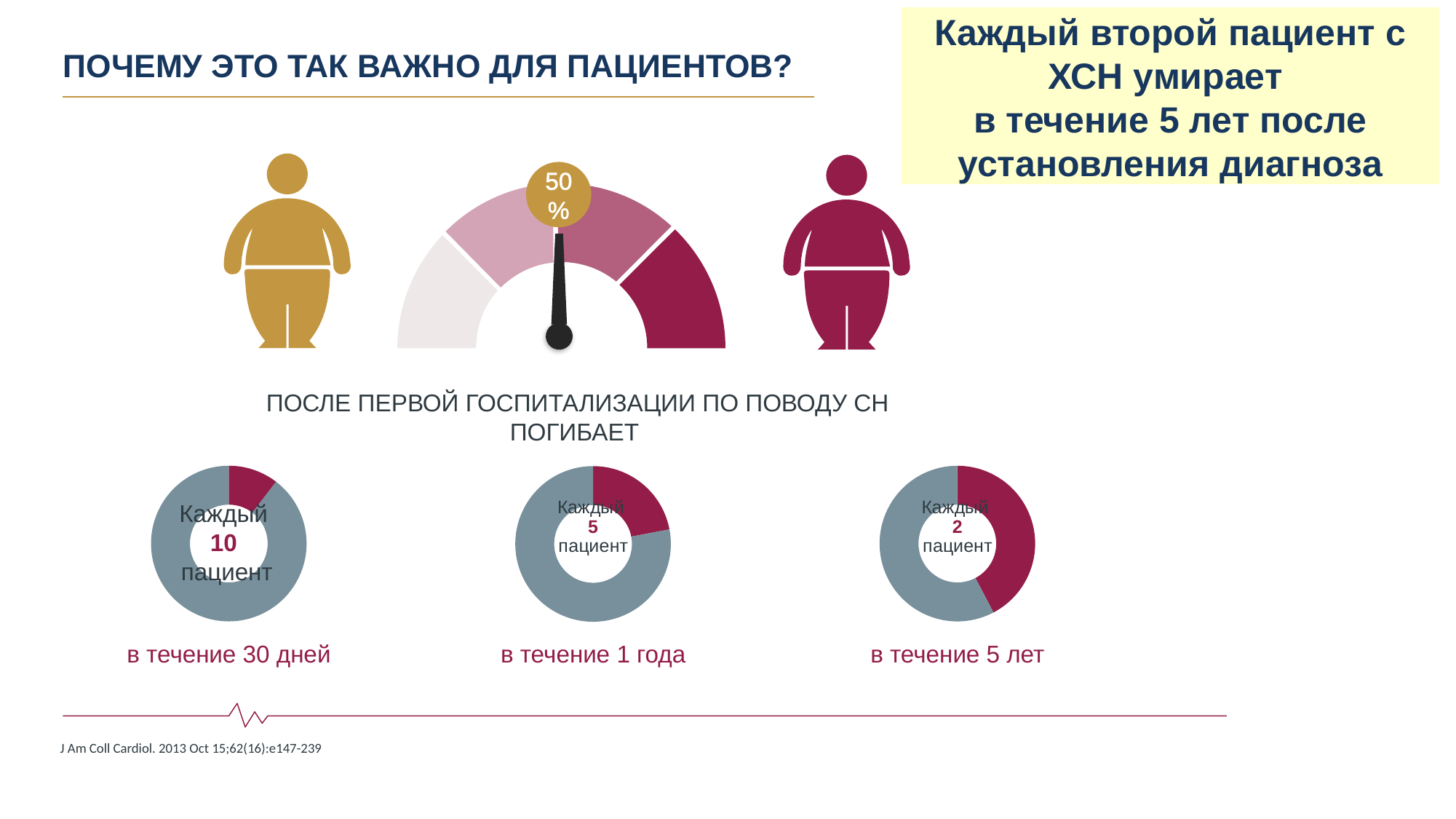
Which of the three donut charts has the largest highlighted (dark red) slice? в течение 5 лет In the donut chart labelled 'в течение 5 лет', which patient is indicated in the centre text? Каждый 2 пациент What kind of chart is used for the three figures in the bottom row of the slide? Donut (pie) chart In the donut chart labelled 'в течение 1 года', which patient is indicated in the centre text? Каждый 5 пациент In the donut chart labelled 'в течение 30 дней', which patient is indicated in the centre text? Каждый 10 пациент What is the caption printed below the gauge chart and the two figures? ПОСЛЕ ПЕРВОЙ ГОСПИТАЛИЗАЦИИ ПО ПОВОДУ СН ПОГИБАЕТ Does the highlighted share of the donut charts increase or decrease from left to right (30 days, 1 year, 5 years)? Increase How many donut charts are shown in the bottom row of the slide? 3 Is the highlighted slice larger in the 'в течение 1 года' donut chart or in the 'в течение 30 дней' donut chart? в течение 1 года Which of the three donut charts has the smallest highlighted (dark red) slice? в течение 30 дней What value is printed on the gauge chart at the top of the slide? 50% What colour is used for the highlighted slice in the three donut charts? Dark red